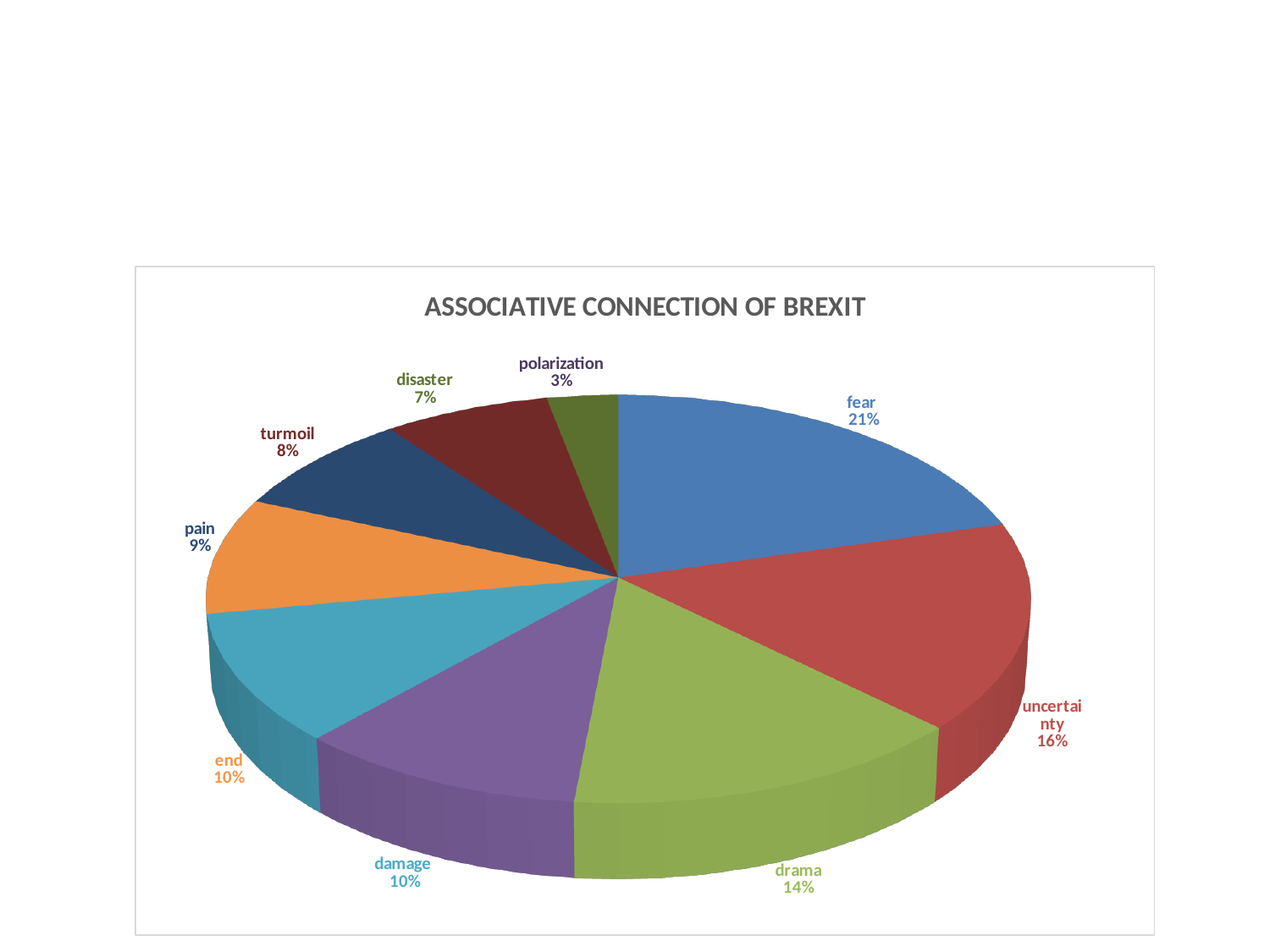
What is the value shown for "drama"? 14% What share does "uncertainty" have in the pie chart? 16% What percentage is shown for "turmoil"? 8% Which category has the largest slice of the pie? fear What is the combined share of "damage" and "end"? 20% How many slices does the pie chart have? 9 Which is larger, the share for "pain" or the share for "disaster"? pain Which category has the smallest slice of the pie? polarization What is the title of the chart? ASSOCIATIVE CONNECTION OF BREXIT What percentage of the pie is labelled "fear"? 21% What is the difference in percentage points between "fear" and "uncertainty"? 5 What kind of chart is shown on the slide? pie chart